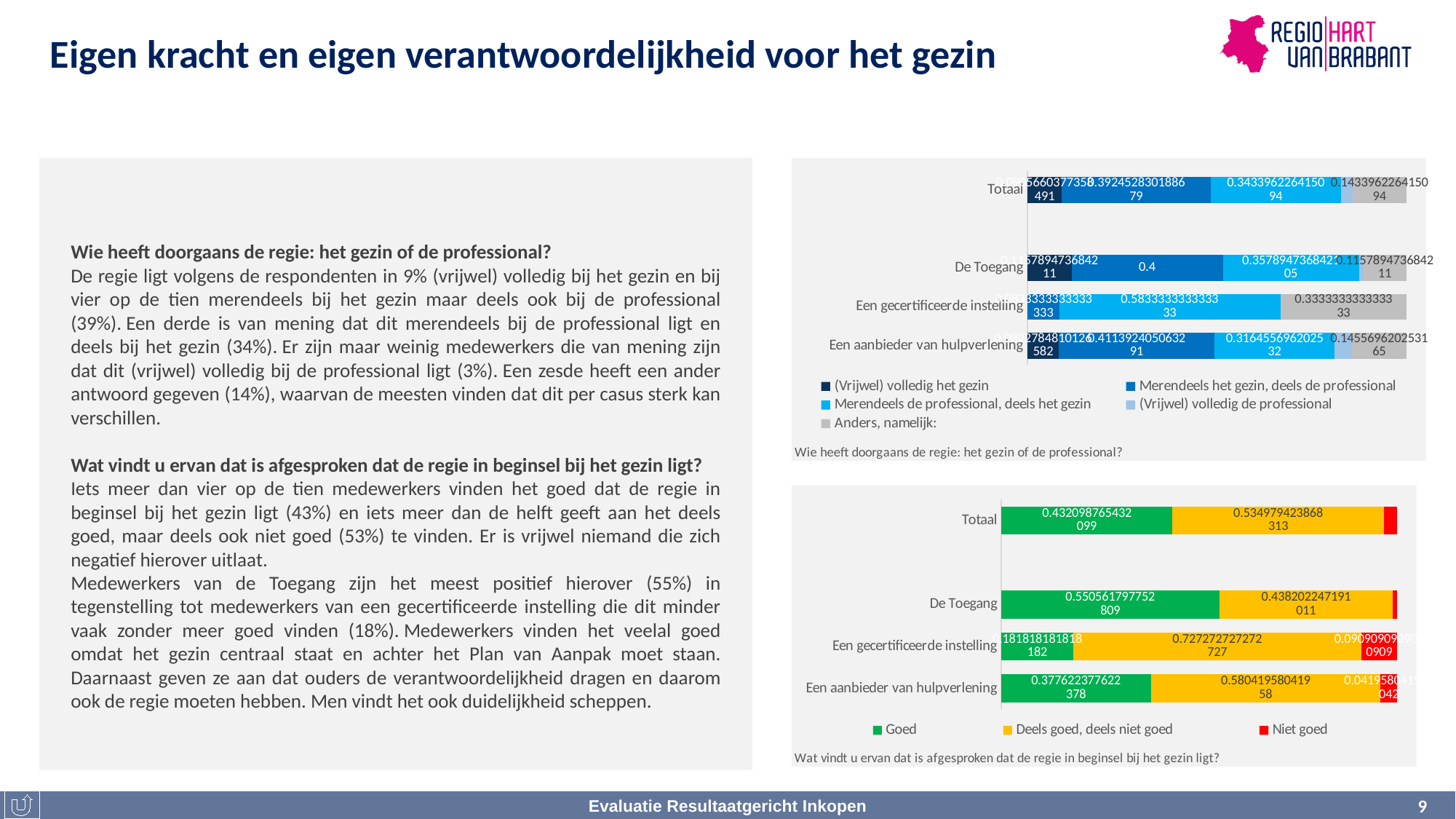
How many categories are shown on the y axis of the chart titled 'Wat vindt u ervan dat is afgesproken dat de regie in beginsel bij het gezin ligt?'? 4 In the chart titled 'Wat vindt u ervan dat is afgesproken dat de regie in beginsel bij het gezin ligt?', which colour represents 'Niet goed'? Red In the chart titled 'Wat vindt u ervan dat is afgesproken dat de regie in beginsel bij het gezin ligt?', which category has the highest value for 'Goed'? De Toegang In the chart titled 'Wat vindt u ervan dat is afgesproken dat de regie in beginsel bij het gezin ligt?', what is the value of 'Deels goed, deels niet goed' for Een gecertificeerde instelling? 0.727272727272727 In the chart titled 'Wat vindt u ervan dat is afgesproken dat de regie in beginsel bij het gezin ligt?', what is the value of 'Goed' for Totaal? 0.432098765432099 What kind of chart is the chart titled 'Wie heeft doorgaans de regie: het gezin of de professional?'? Stacked bar chart In the chart titled 'Wat vindt u ervan dat is afgesproken dat de regie in beginsel bij het gezin ligt?', what is the value of 'Goed' for De Toegang? 0.550561797752809 In the chart titled 'Wie heeft doorgaans de regie: het gezin of de professional?', what is the value of 'Anders, namelijk:' for Een gecertificeerde instelling? 0.333333333333333 In the chart titled 'Wat vindt u ervan dat is afgesproken dat de regie in beginsel bij het gezin ligt?', for Totaal, which is larger: 'Goed' or 'Deels goed, deels niet goed'? Deels goed, deels niet goed In the chart titled 'Wie heeft doorgaans de regie: het gezin of de professional?', what is the value of 'Merendeels het gezin, deels de professional' for De Toegang? 0.4 How many series does the legend list in the chart titled 'Wie heeft doorgaans de regie: het gezin of de professional?'? 5 How many series does the legend list in the chart titled 'Wat vindt u ervan dat is afgesproken dat de regie in beginsel bij het gezin ligt?'? 3